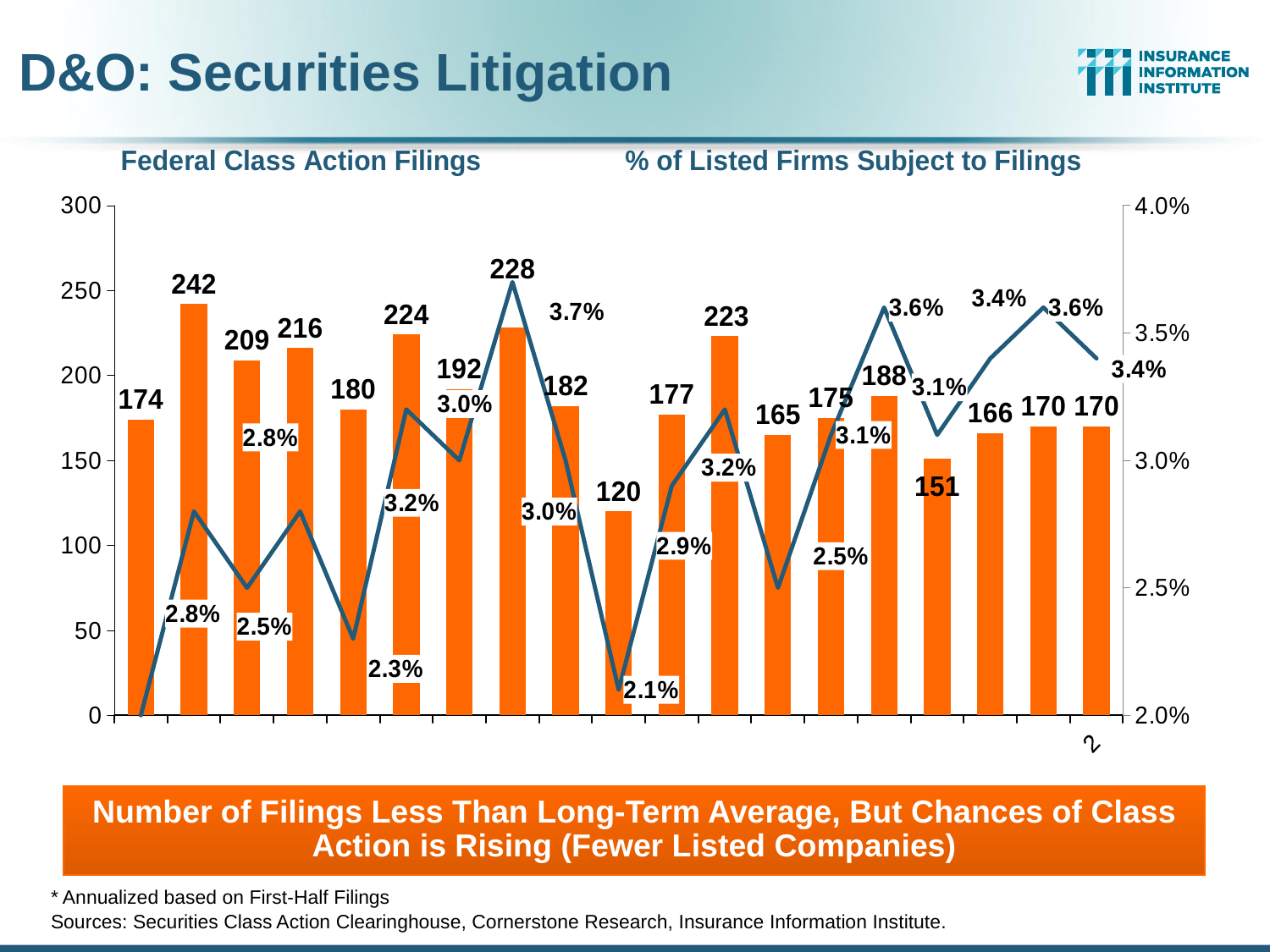
What is the value of the last (rightmost) point on the % of Listed Firms Subject to Filings line? 3.4% What is the difference between the highest and lowest Federal Class Action Filings bar values? 122 How many Federal Class Action Filings bars are plotted on the chart? 19 What is the lowest value among the Federal Class Action Filings bars? 120 What is the highest value among the Federal Class Action Filings bars? 242 What is the highest value shown on the % of Listed Firms Subject to Filings line? 3.7% What is the maximum value shown on the right-hand (percentage) axis? 4.0% What kind of chart is used to show Federal Class Action Filings? Bar chart What is the value of the last (rightmost) Federal Class Action Filings bar? 170 What is the lowest value shown on the % of Listed Firms Subject to Filings line? 2.0% What is the value of the first (leftmost) Federal Class Action Filings bar? 174 Which is larger, the second bar (242) or the eighth bar (228) of Federal Class Action Filings? 242